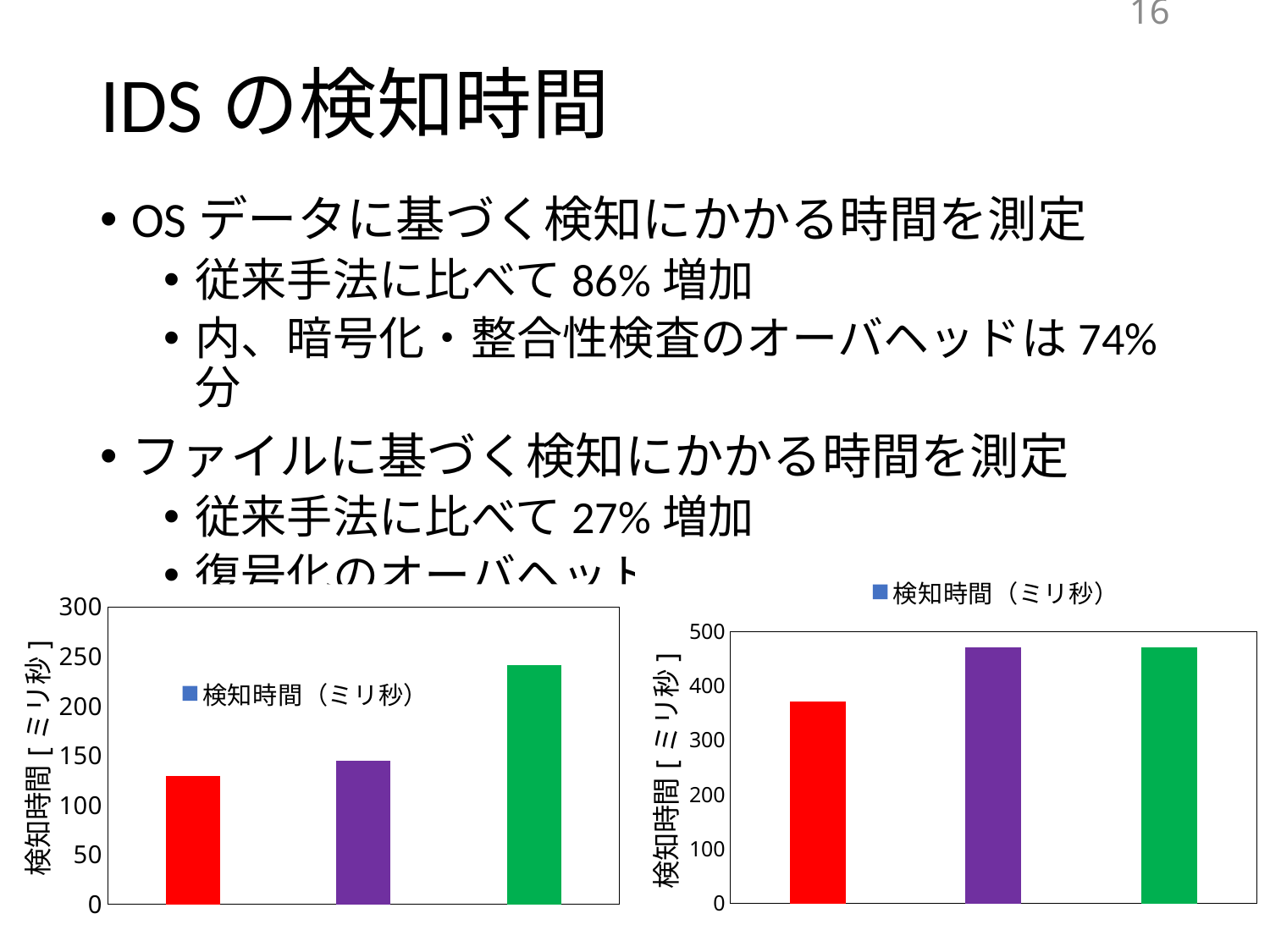
In the chart on the right, is the value of the red (leftmost) bar greater or less than 300? greater What kind of chart is the chart on the left of the slide? bar chart How many bars are plotted in the chart on the right of the slide? 3 In the chart on the left, is the value of the red (leftmost) bar greater or less than 150? less In the chart on the right, is the value of the purple (middle) bar greater or less than 400? greater In the chart on the right, which is larger, the red (leftmost) bar or the purple (middle) bar? the purple (middle) bar What is the legend entry shown in the chart on the right of the slide? 検知時間（ミリ秒） In the chart on the left, which bar is the lowest? the red (leftmost) bar In the chart on the left, which bar is the highest? the green (rightmost) bar What is the y-axis title of the chart on the left of the slide? 検知時間 [ミリ秒] How many series does the legend of the chart on the left list? 1